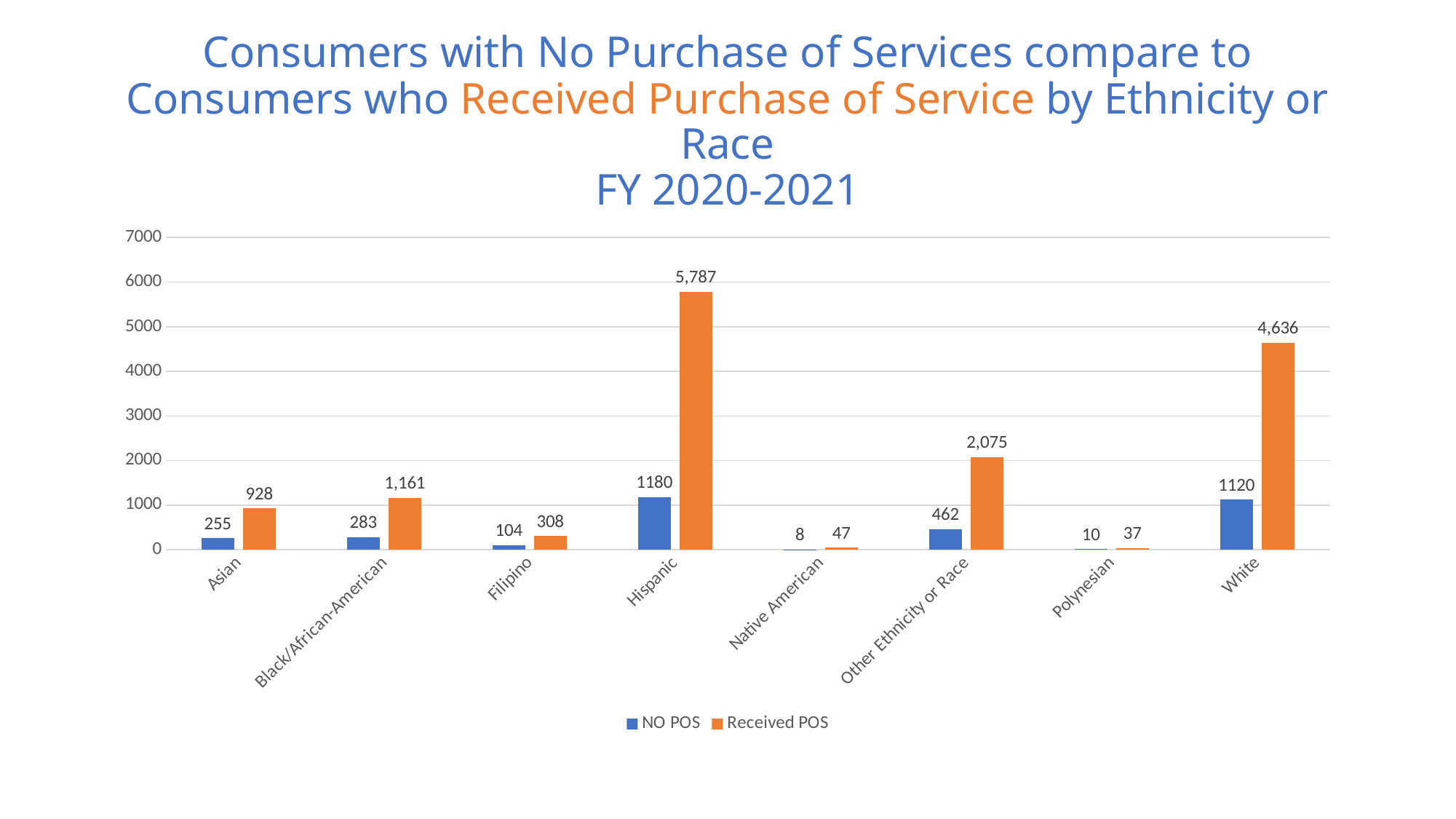
What is the NO POS value for Asian? 255 How many ethnicity or race categories are shown on the x axis? 8 Which category has the highest Received POS value? Hispanic What is the Received POS value for Other Ethnicity or Race? 2,075 What kind of chart is shown on the slide? Bar chart What is the difference between the Received POS and NO POS values for White? 3,516 Which colour represents the Received POS series? Orange How many series does the legend list? 2 Which is larger for Filipino: the NO POS value or the Received POS value? Received POS Is the Received POS value for White greater or less than 4000? greater What is the Received POS value for Hispanic? 5,787 Which category has the lowest NO POS value? Native American